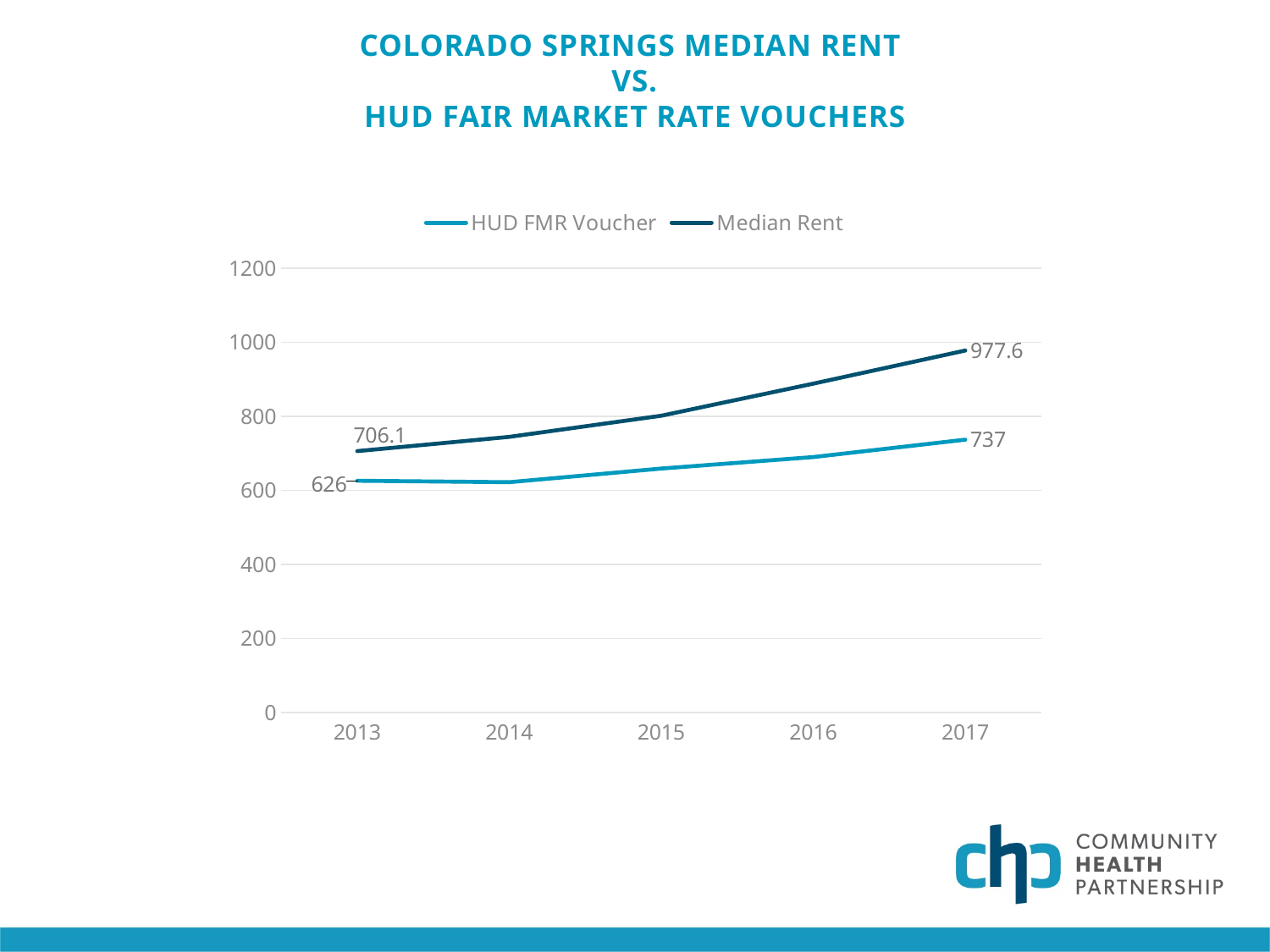
How many years are shown on the x axis? 5 What is the difference between the Median Rent and the HUD FMR Voucher in 2017? 240.6 How many series does the legend list? 2 What is the Median Rent value for 2017? 977.6 What is the Median Rent value for 2013? 706.1 What is the HUD FMR Voucher value for 2017? 737 What is the difference between the Median Rent and the HUD FMR Voucher in 2013? 80.1 Is the Median Rent value for 2016 greater or less than 800? greater What kind of chart is shown on the slide? Line chart Which series has the higher value in 2015, HUD FMR Voucher or Median Rent? Median Rent What is the HUD FMR Voucher value for 2013? 626 Is the HUD FMR Voucher value for 2015 greater or less than 800? less